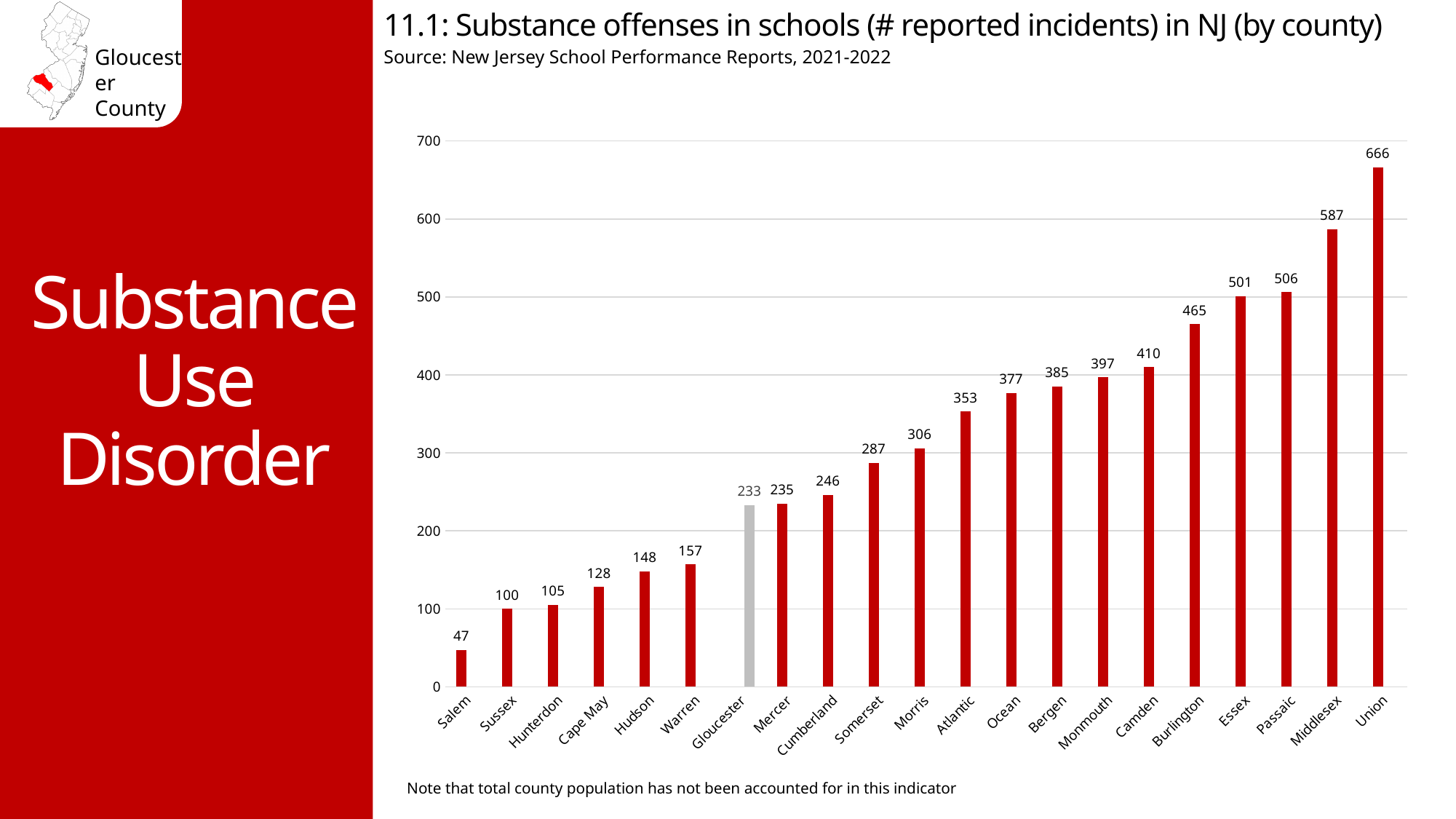
Which has a higher value, Camden or Burlington? Burlington Is the value for Essex greater or less than 500? greater Which county has the lowest number of reported incidents? Salem Which county's bar is coloured grey instead of red? Gloucester What is the difference between the values for Union and Middlesex? 79 What is the value shown for Middlesex County? 587 How many counties are shown on the chart? 21 Which county has the highest number of reported incidents? Union What is the number of reported substance offense incidents in schools for Gloucester County? 233 How many more incidents does Mercer have than Gloucester? 2 What kind of chart is shown on the slide? Bar chart Do the values rise or fall moving from left to right along the x axis? Rise